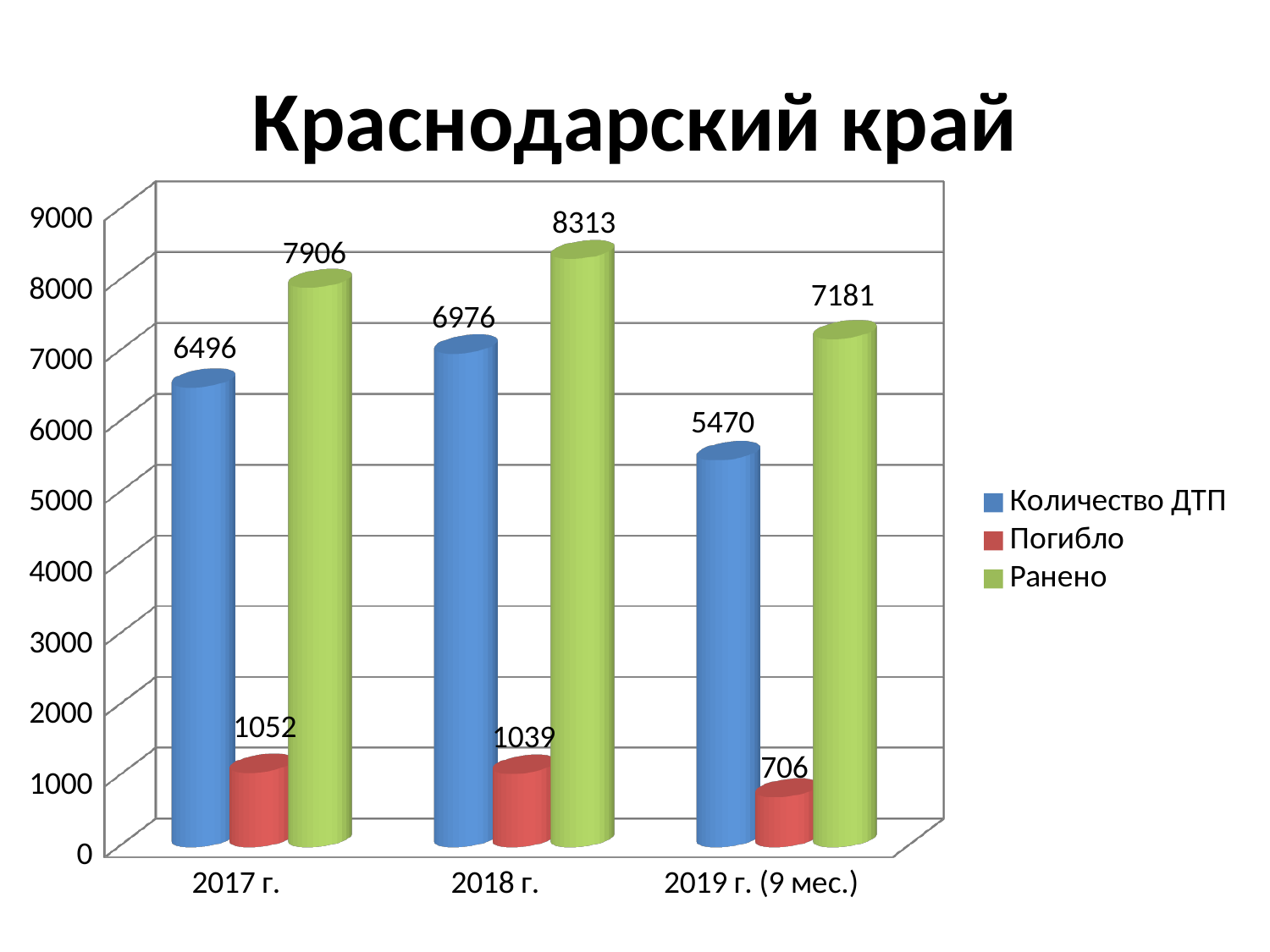
In which year is Ранено highest? 2018 г. How many categories are shown on the x axis? 3 What is the value of Погибло for 2019 г. (9 мес.)? 706 Which is larger: Погибло in 2017 г. or Погибло in 2018 г.? 2017 г. What is the title of the chart? Краснодарский край What is the value of Количество ДТП for 2017 г.? 6496 How many series does the legend list? 3 Is the value of Ранено for 2019 г. (9 мес.) greater or less than 7000? greater In which category is Погибло lowest? 2019 г. (9 мес.) What kind of chart is shown on the slide? bar chart What is the difference between Количество ДТП in 2018 г. and 2017 г.? 480 What is the value of Ранено for 2018 г.? 8313